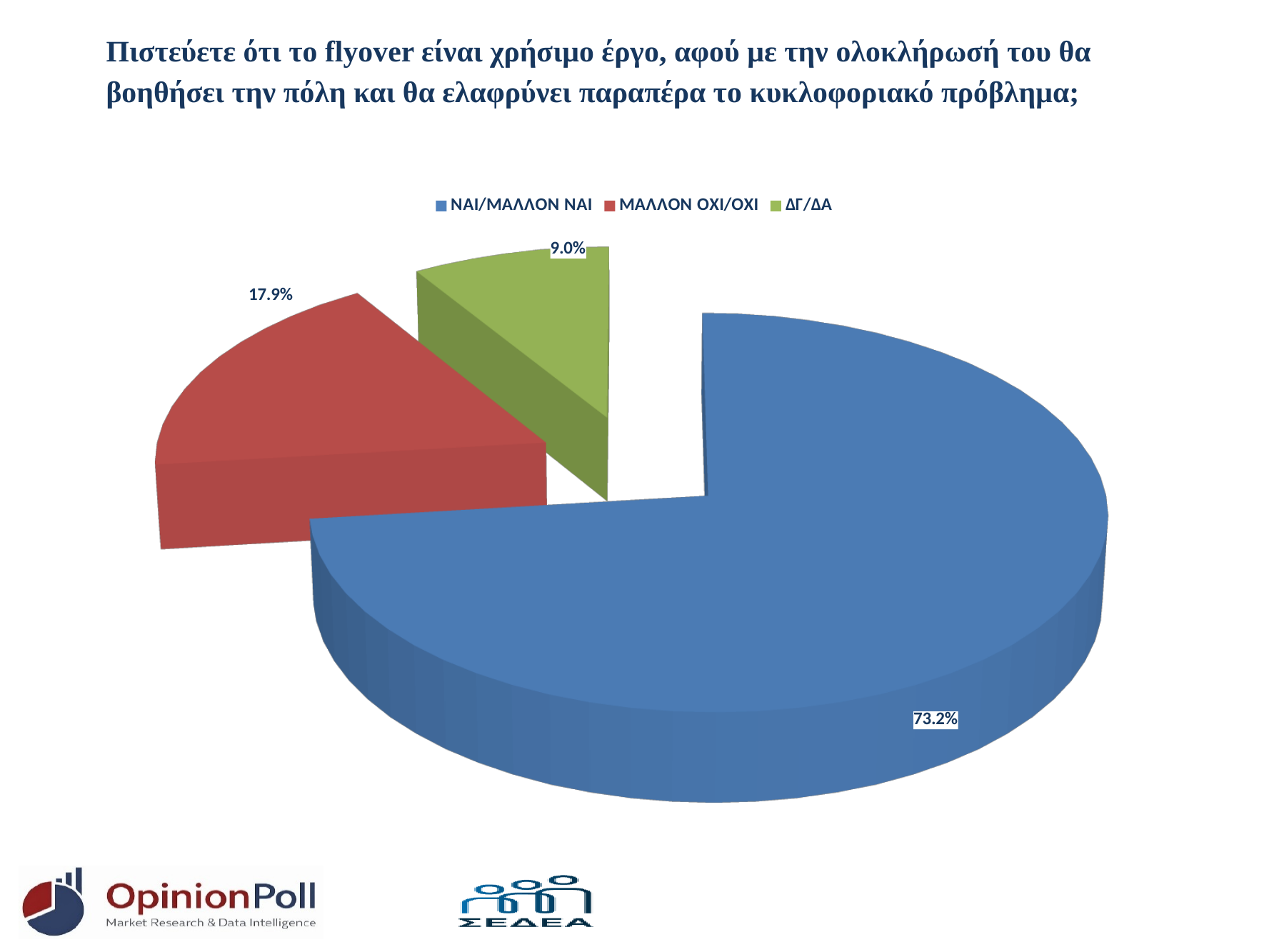
Which response category has the largest share of the pie? ΝΑΙ/ΜΑΛΛΟΝ ΝΑΙ How many entries does the legend list? 3 How many slices does the pie chart have? 3 What percentage of respondents answered ΝΑΙ/ΜΑΛΛΟΝ ΝΑΙ? 73.2% Which is larger, the share for ΜΑΛΛΟΝ ΟΧΙ/ΟΧΙ or the share for ΔΓ/ΔΑ? ΜΑΛΛΟΝ ΟΧΙ/ΟΧΙ What percentage of respondents answered ΔΓ/ΔΑ? 9.0% What type of chart is shown on the slide? Pie chart Which response category has the smallest share of the pie? ΔΓ/ΔΑ What colour is the slice for ΔΓ/ΔΑ? Green How many percentage points higher is ΝΑΙ/ΜΑΛΛΟΝ ΝΑΙ than ΜΑΛΛΟΝ ΟΧΙ/ΟΧΙ? 55.3 percentage points How many percentage points higher is ΜΑΛΛΟΝ ΟΧΙ/ΟΧΙ than ΔΓ/ΔΑ? 8.9 percentage points What percentage of respondents answered ΜΑΛΛΟΝ ΟΧΙ/ΟΧΙ? 17.9%